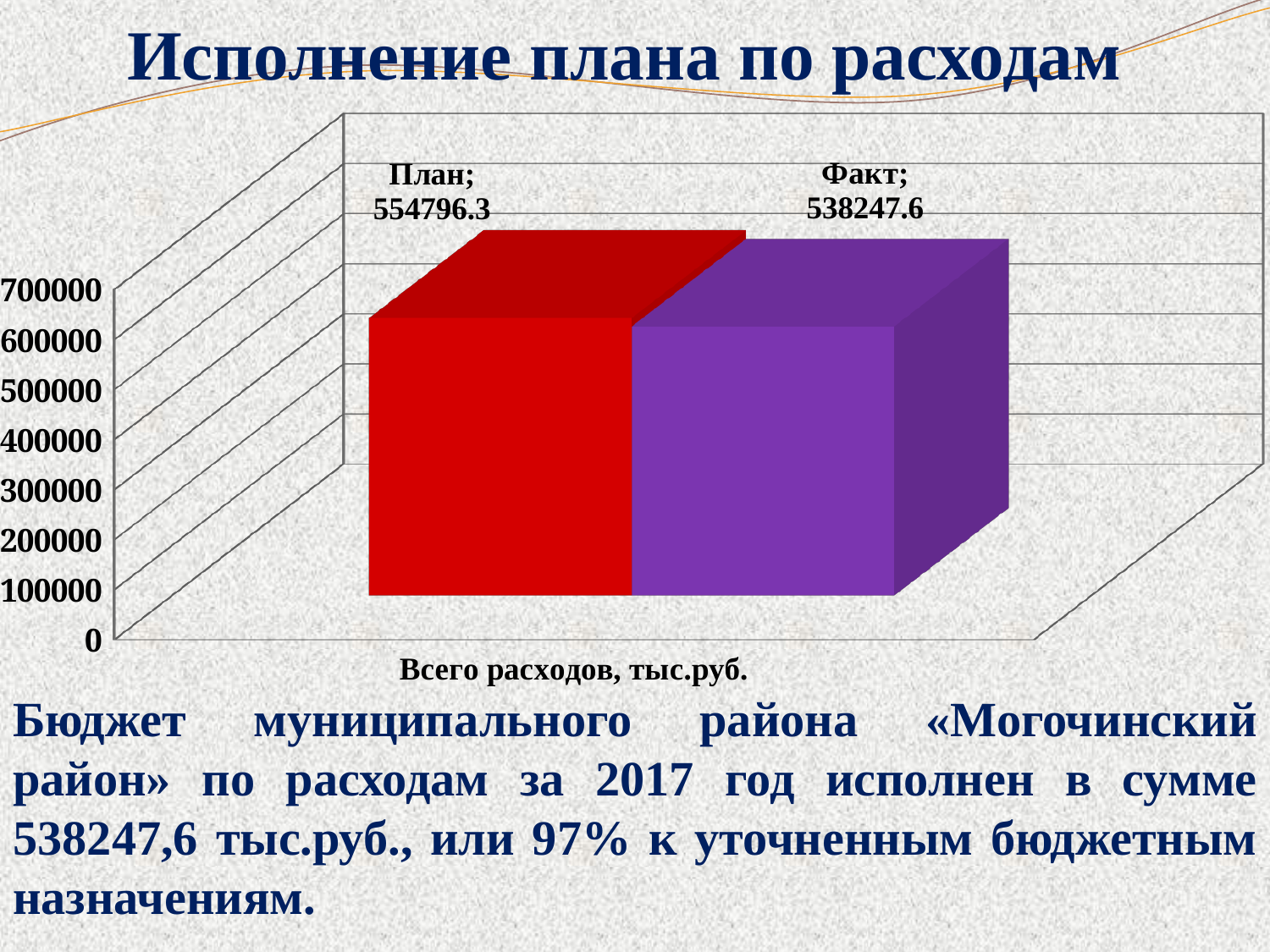
Which bar is higher, План or Факт? План Is the value for План greater or less than 600000? less What is the label shown below the bars on the horizontal axis? Всего расходов, тыс.руб. What type of chart is shown on the slide? bar chart What is the difference between the План and Факт values? 16548.7 What is the title of the chart? Исполнение плана по расходам How many bars are plotted on the chart? 2 What is the value of the Факт bar? 538247.6 Is the value for Факт greater or less than 500000? greater What is the value of the План bar? 554796.3 What is the highest value shown on the vertical axis? 700000 Which bar has the lowest value? Факт